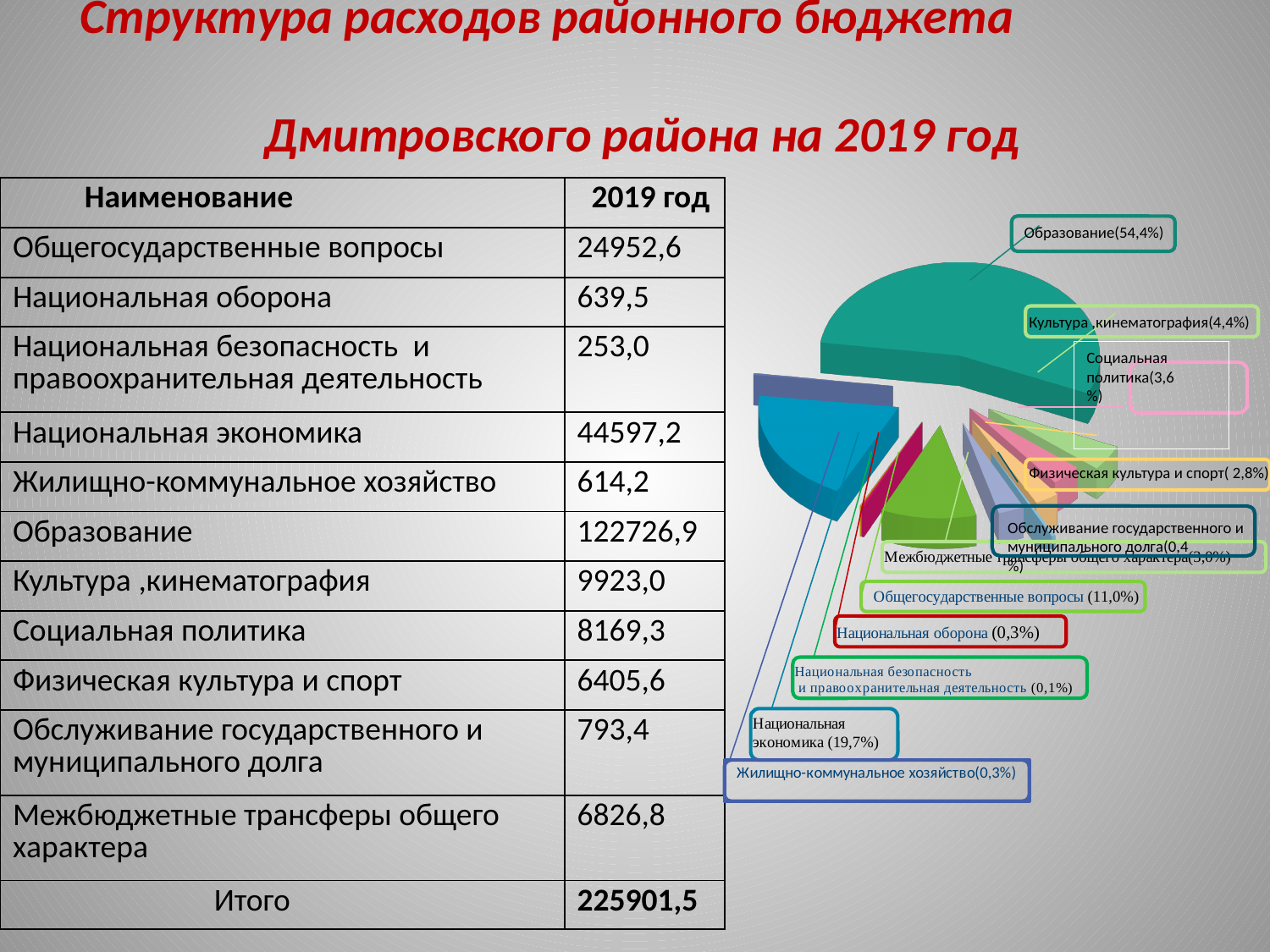
By how many percentage points does the Образование share exceed the Национальная экономика share in the pie chart? 34,7 Which slice is larger in the pie chart: Национальная экономика or Общегосударственные вопросы? Национальная экономика What share of the pie chart does Образование account for? 54,4% What share of the pie chart does Общегосударственные вопросы account for? 11,0% Which category has the smallest slice of the pie chart? Национальная безопасность и правоохранительная деятельность What kind of chart is shown on the slide? pie chart What share of the pie chart does Социальная политика account for? 3,6% What share of the pie chart does Культура, кинематография account for? 4,4% What share of the pie chart does Национальная экономика account for? 19,7% What share of the pie chart does Физическая культура и спорт account for? 2,8% Which category has the largest slice of the pie chart? Образование What is the title of the slide containing the pie chart? Структура расходов районного бюджета Дмитровского района на 2019 год